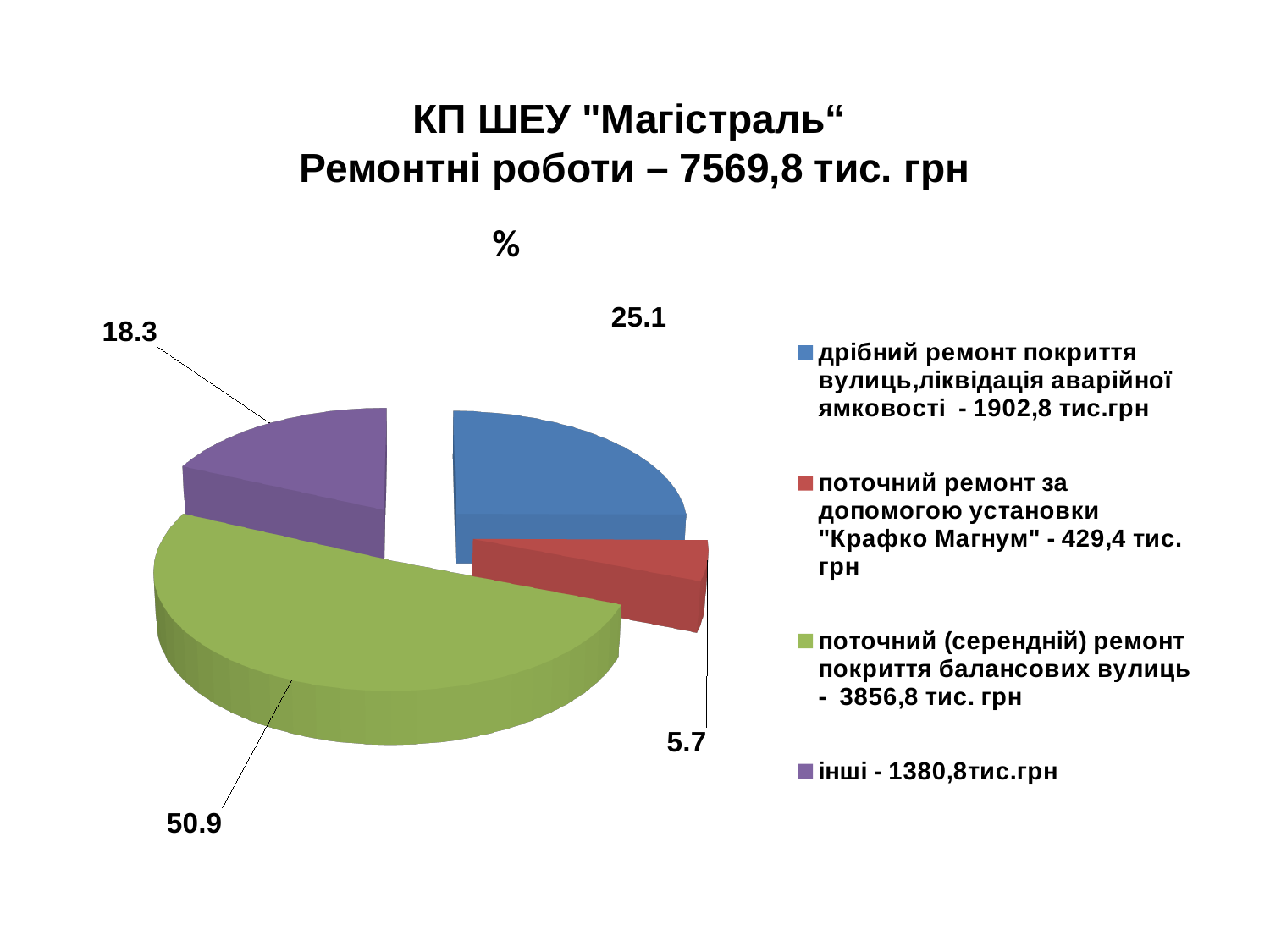
What is the chart's title? % How many entries does the legend list? 4 Which slice has the smallest share of the pie? поточний ремонт за допомогою установки "Крафко Магнум" What is the difference in percentage points between the "дрібний ремонт" slice (25.1) and the "інші" slice (18.3)? 6.8 What percentage is shown for the slice "поточний (серендній) ремонт покриття балансових вулиць"? 50.9 What percentage is shown for the slice "інші"? 18.3 What percentage is shown for the slice "дрібний ремонт покриття вулиць, ліквідація аварійної ямковості"? 25.1 Which colour is used for the "інші" slice? purple What percentage is shown for the slice "поточний ремонт за допомогою установки "Крафко Магнум""? 5.7 How many slices does the pie chart have? 4 What kind of chart is shown on the slide? pie chart Which slice has the largest share of the pie? поточний (серендній) ремонт покриття балансових вулиць